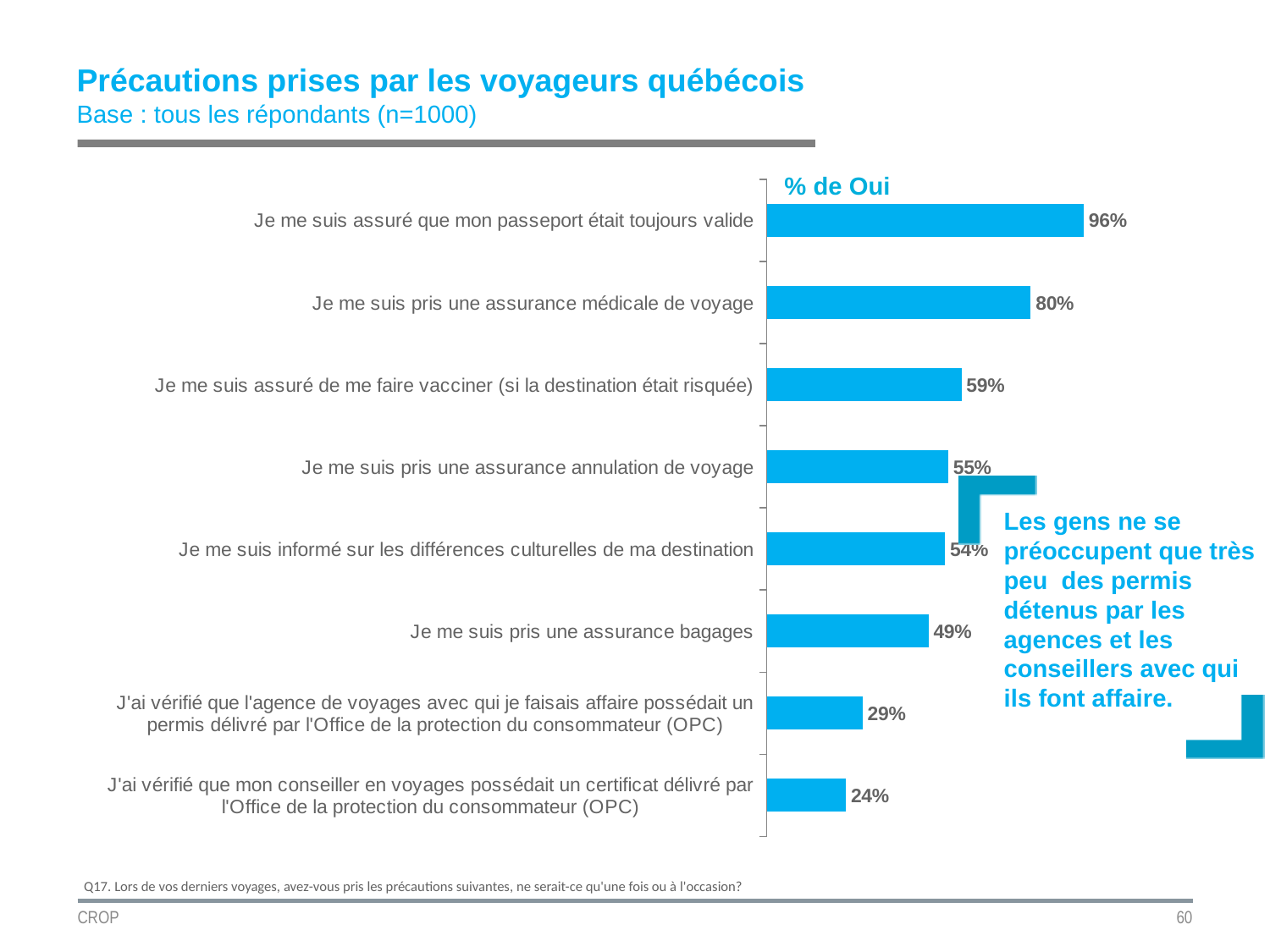
What is the value for "Je me suis pris une assurance bagages"? 49% Which precaution has the highest percentage of "Oui"? Je me suis assuré que mon passeport était toujours valide How many precautions (categories) are shown in the chart? 8 What is the difference between the value for "Je me suis pris une assurance annulation de voyage" and the value for "Je me suis pris une assurance bagages"? 6% Which is larger: the value for "Je me suis assuré de me faire vacciner (si la destination était risquée)" or the value for "Je me suis pris une assurance bagages"? Je me suis assuré de me faire vacciner (si la destination était risquée) What percentage of respondents said they made sure their passport was still valid ("Je me suis assuré que mon passeport était toujours valide")? 96% What is the difference between the value for "Je me suis assuré que mon passeport était toujours valide" and the value for "Je me suis pris une assurance médicale de voyage"? 16% Which precaution has the lowest percentage of "Oui"? J'ai vérifié que mon conseiller en voyages possédait un certificat délivré par l'Office de la protection du consommateur (OPC) What kind of chart is shown on the slide? Bar chart What is the value for "Je me suis pris une assurance médicale de voyage"? 80% What is the value for "J'ai vérifié que mon conseiller en voyages possédait un certificat délivré par l'Office de la protection du consommateur (OPC)"? 24% What is the label shown above the bars in the chart? % de Oui